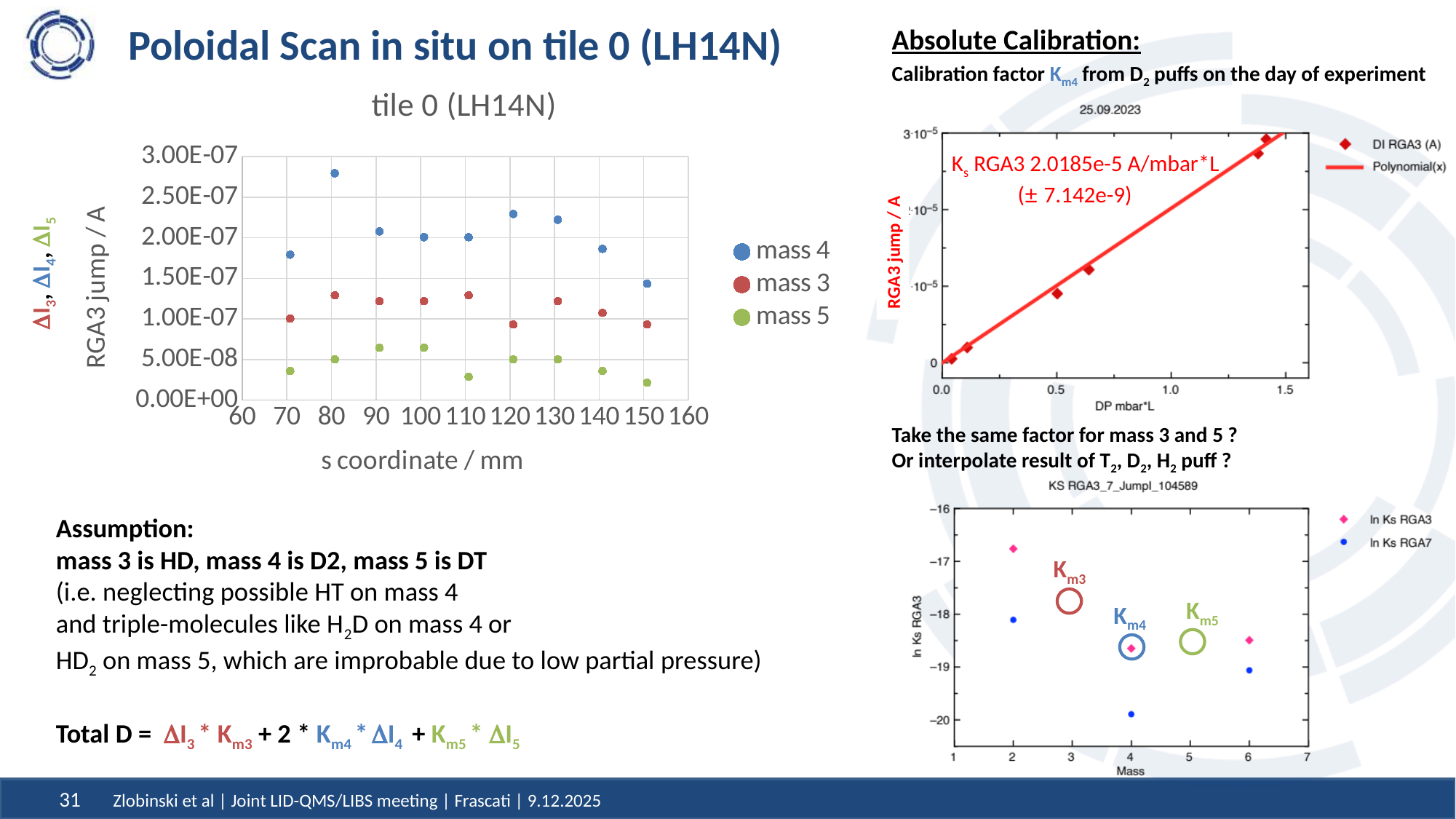
In the bottom-right chart 'KS RGA3_7_JumpI_104589', at mass 4, which series has the larger value, ln Ks RGA3 or ln Ks RGA7? ln Ks RGA3 In the 'tile 0 (LH14N)' chart, at s = 100 mm, which series has the larger value, mass 4 or mass 3? mass 4 In the 'tile 0 (LH14N)' chart, what are the legend entries? mass 4, mass 3, mass 5 In the 'tile 0 (LH14N)' chart, is the mass 5 value at s = 150 mm greater or less than 5.00E-08? less In the bottom-right chart 'KS RGA3_7_JumpI_104589', how many series does the legend list? 2 What kind of chart is the 'tile 0 (LH14N)' chart on the left? scatter chart In the 'tile 0 (LH14N)' chart, how many data points are plotted for the mass 4 series? 9 In the 'tile 0 (LH14N)' chart, is the mass 4 value at s = 80 mm greater or less than 2.50E-07? greater In the calibration chart titled '25.09.2023' on the right, what value of Ks RGA3 is stated in the annotation? 2.0185e-5 A/mbar*L In the 'tile 0 (LH14N)' chart, how many series does the legend list? 3